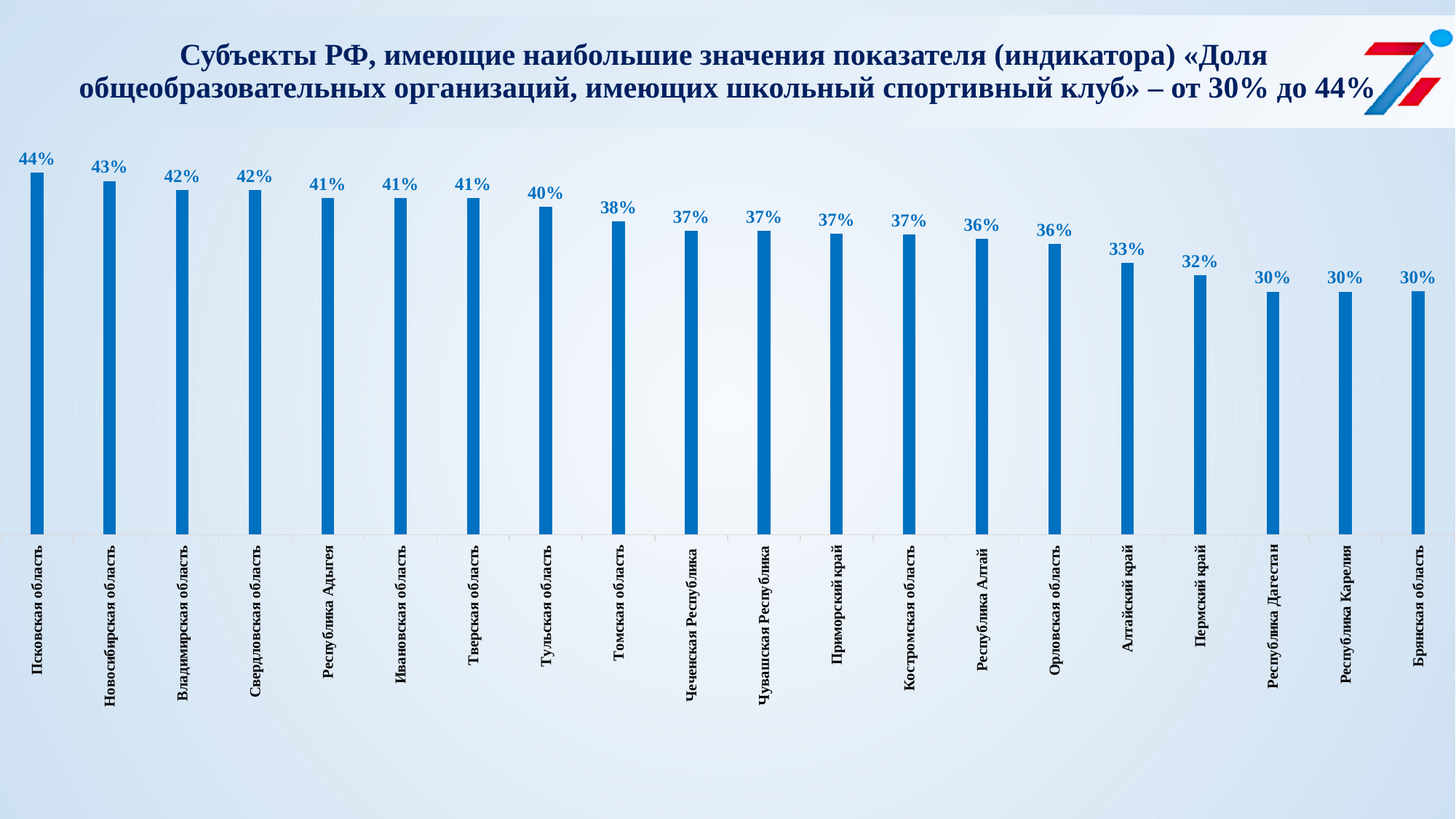
What is the value for Пермский край? 32% What is the value for Томская область? 38% What is the difference between the values for Новосибирская область and Томская область? 5% What kind of chart is shown on the slide? Bar chart Which is larger, the value for Тульская область or the value for Орловская область? Тульская область What is the value for Псковская область? 44% What is the difference between the values for Псковская область and Брянская область? 14% What is the value for Алтайский край? 33% What is the lowest value shown on the chart? 30% How many regions are shown on the chart? 20 Which region has the highest value on the chart? Псковская область Do the values rise or fall from left to right along the x axis? Fall